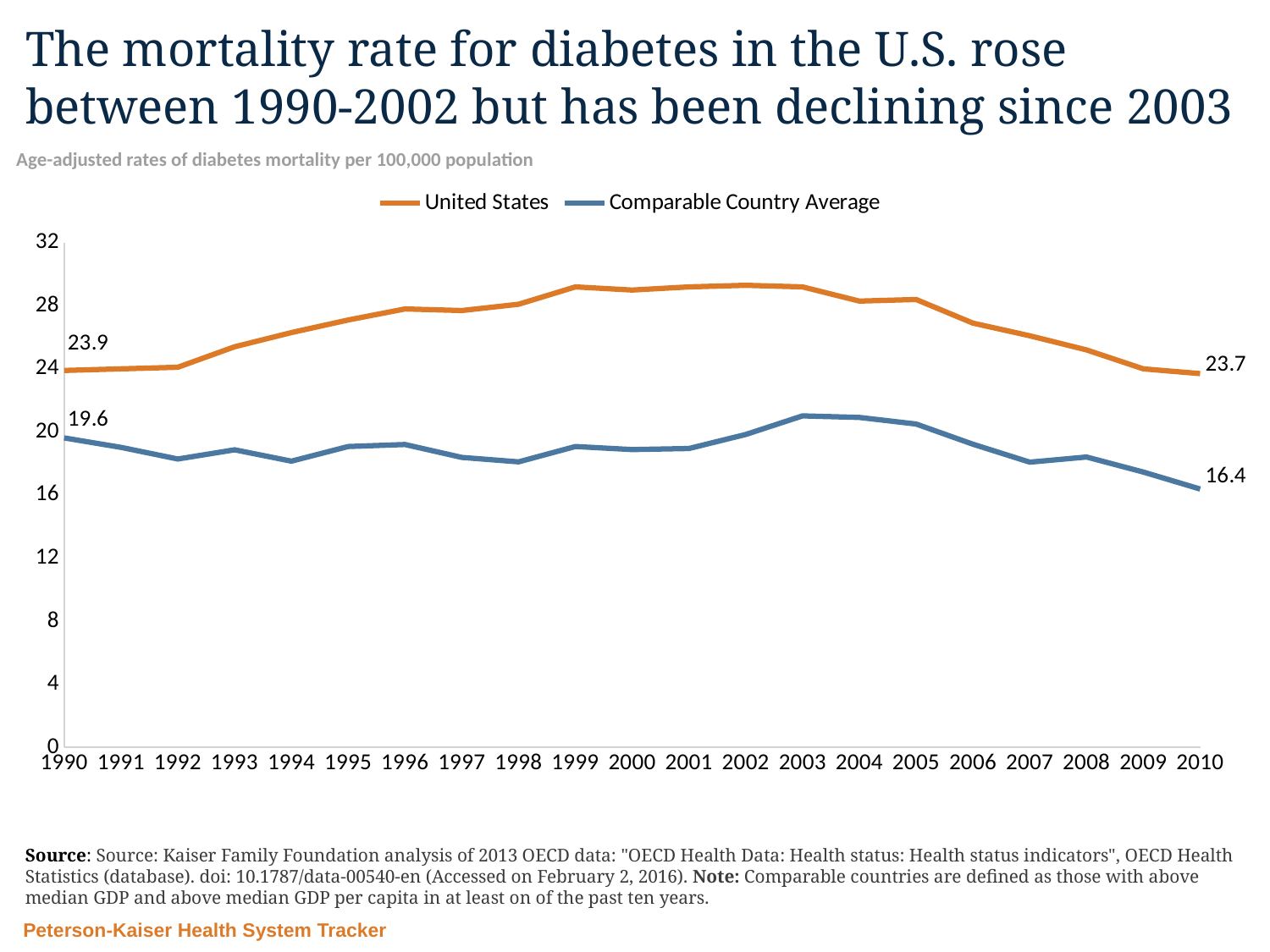
What was the United States diabetes mortality rate in 1990? 23.9 How many series does the legend list? 2 What kind of chart is shown on the slide? Line chart What was the Comparable Country Average diabetes mortality rate in 2010? 16.4 How many years are shown on the x axis? 21 What is the difference between the United States and Comparable Country Average rates in 2010? 7.3 What was the Comparable Country Average diabetes mortality rate in 1990? 19.6 Which series had the higher value in 2010, United States or Comparable Country Average? United States Is the United States value for 2002 greater or less than 28? greater What was the United States diabetes mortality rate in 2010? 23.7 Is the Comparable Country Average value for 2003 greater or less than 20? greater By how much did the Comparable Country Average rate fall from 1990 to 2010? 3.2